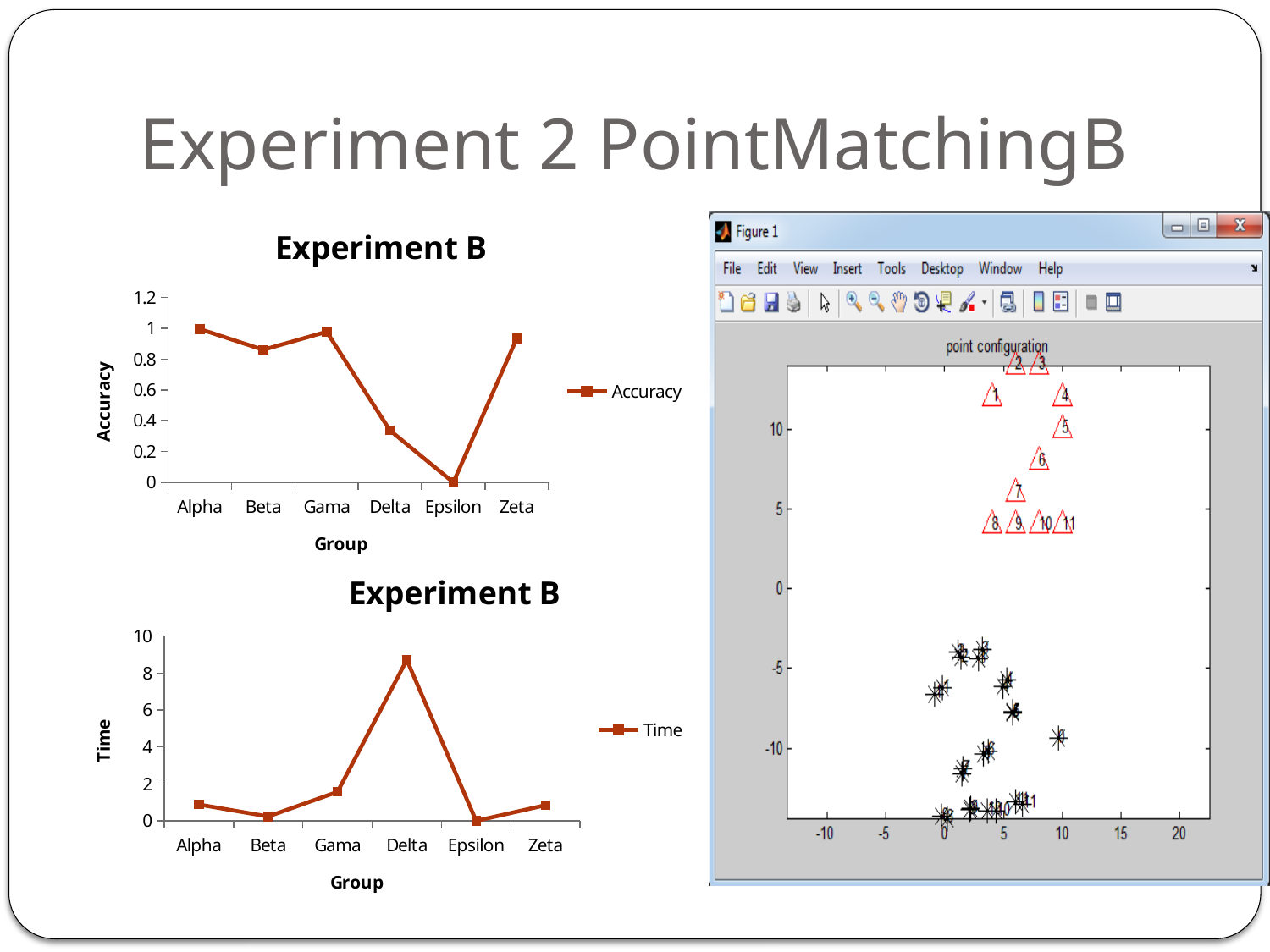
What is the y-axis label of the bottom-left chart? Time What kind of chart is the top-left chart titled Experiment B (Accuracy)? line chart In the top-left Accuracy chart, what is the accuracy for Epsilon? 0 In the top-left Accuracy chart, is the value for Delta greater or less than 0.4? less In the top-left Accuracy chart, which group has the lowest accuracy? Epsilon In the bottom-left Time chart, which group has the highest time? Delta In the bottom-left Time chart, how many series does the legend list? 1 In the bottom-left Time chart, is the value for Delta greater or less than 8? greater In the bottom-left Time chart, what is the time for Epsilon? 0 In the top-left Accuracy chart, do the values rise or fall from Gama to Epsilon? fall In the top-left Accuracy chart, which has the higher accuracy, Beta or Delta? Beta In the top-left Accuracy chart, how many groups are shown on the x axis? 6